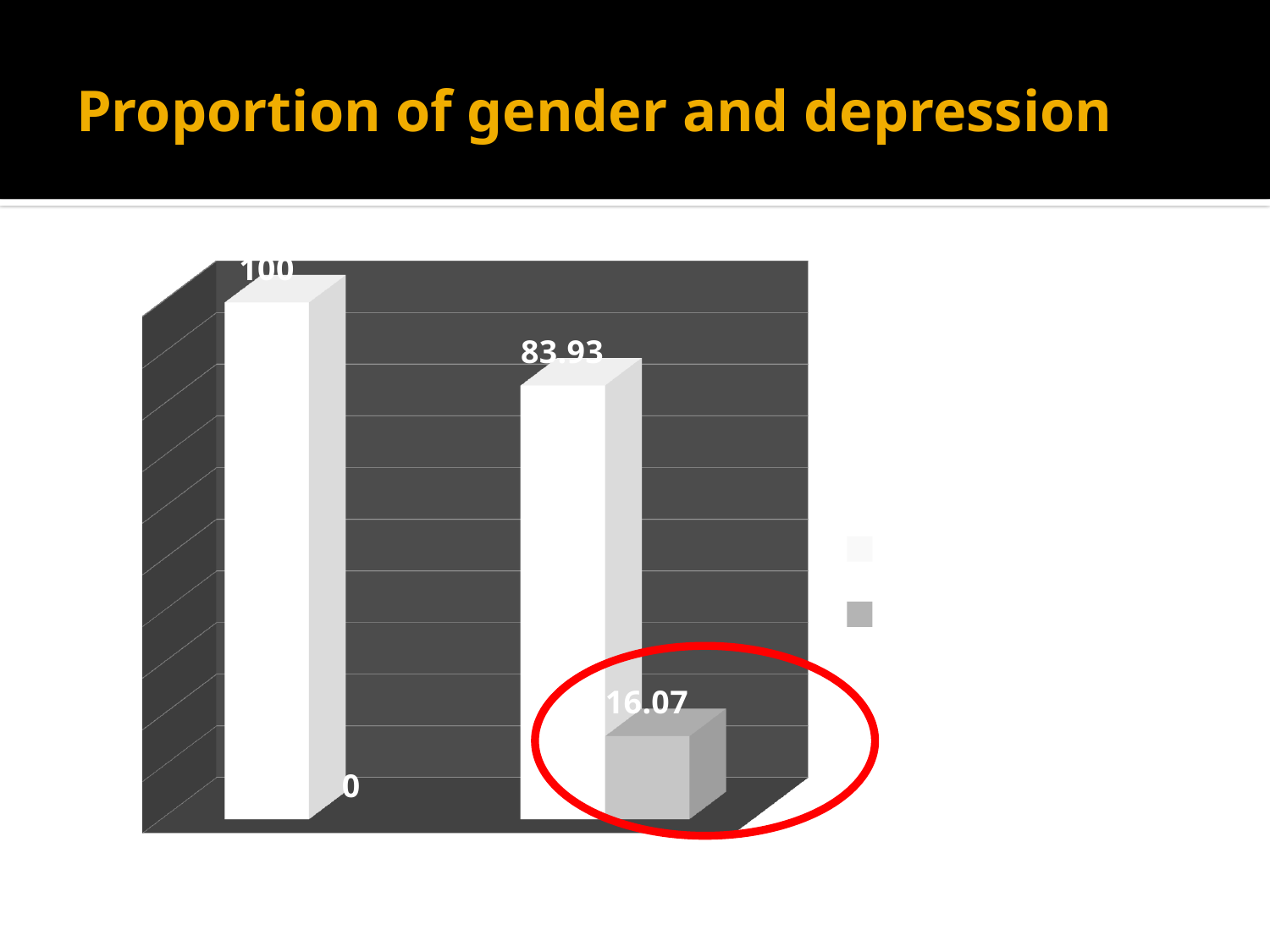
What is the value labelled on the tallest bar in the chart? 100 What is the smallest value labelled in the chart? 0 What colour is the bar circled in red? grey What kind of chart is shown on the slide? bar chart What is the difference between the two white bars' values (100 and 83.93)? 16.07 How many series does the legend show? 2 How many data labels are printed on the chart? 4 What is the title of the chart on the slide? Proportion of gender and depression Which white bar has the larger value, the left one or the right one? the left one What is the value labelled on the bar circled in red? 16.07 What is the total of the two values in the right-hand group (83.93 and 16.07)? 100 What is the value labelled on the white bar in the right-hand group? 83.93